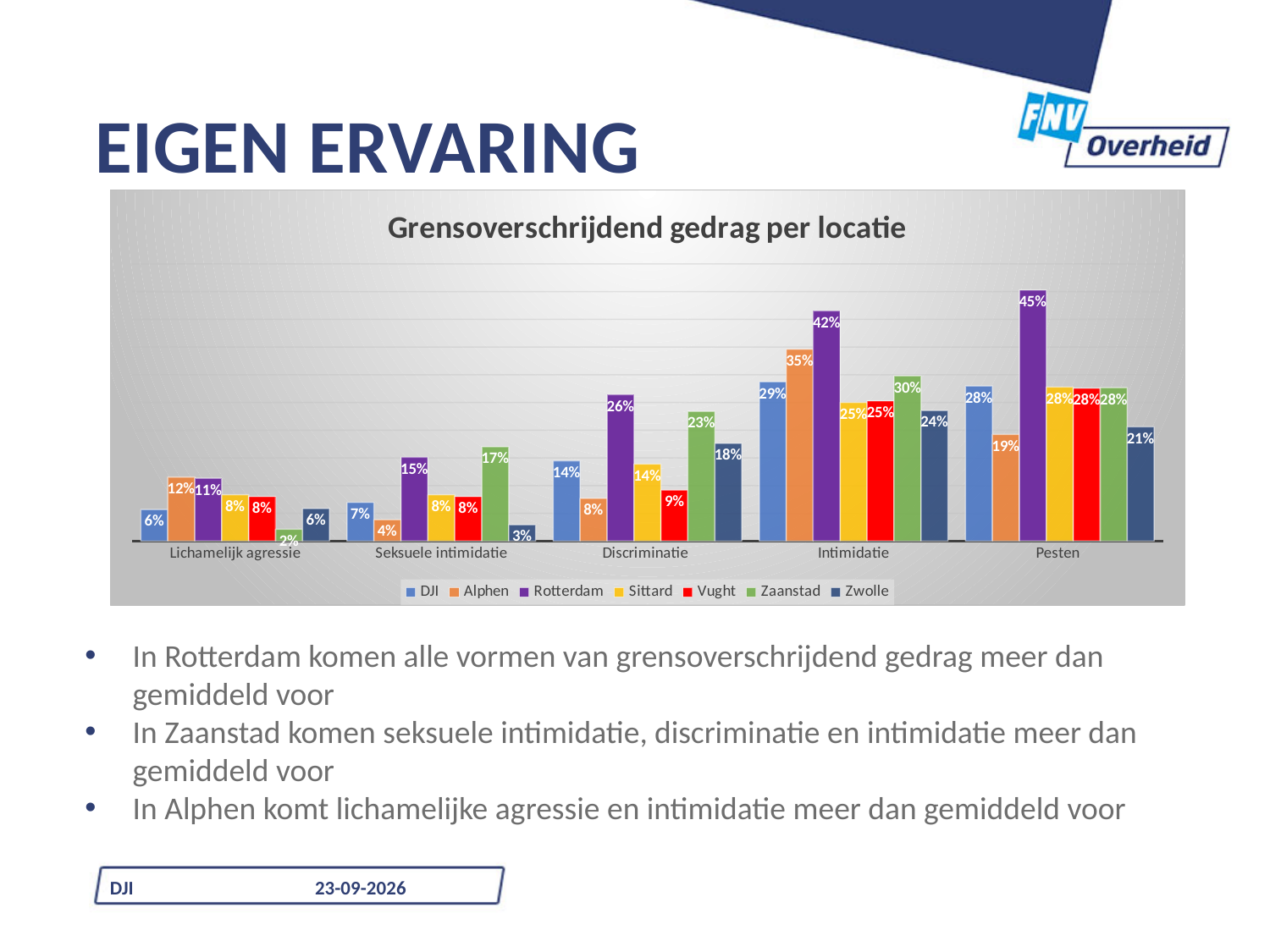
How many series does the legend list? 7 How many categories are shown on the x axis? 5 Which is larger in the Discriminatie category: Rotterdam or Zaanstad? Rotterdam Which location has the lowest value in the Lichamelijk agressie category? Zaanstad What is the value for Rotterdam in the Pesten category? 45% What is the value for Zwolle in the Discriminatie category? 18% What is the title of the chart? Grensoverschrijdend gedrag per locatie What is the value for Zaanstad in the Seksuele intimidatie category? 17% Which location has the highest value in the Intimidatie category? Rotterdam What kind of chart is shown on the slide? Bar chart What is the difference between Rotterdam and Alphen in the Pesten category? 26% What is the value for Alphen in the Intimidatie category? 35%